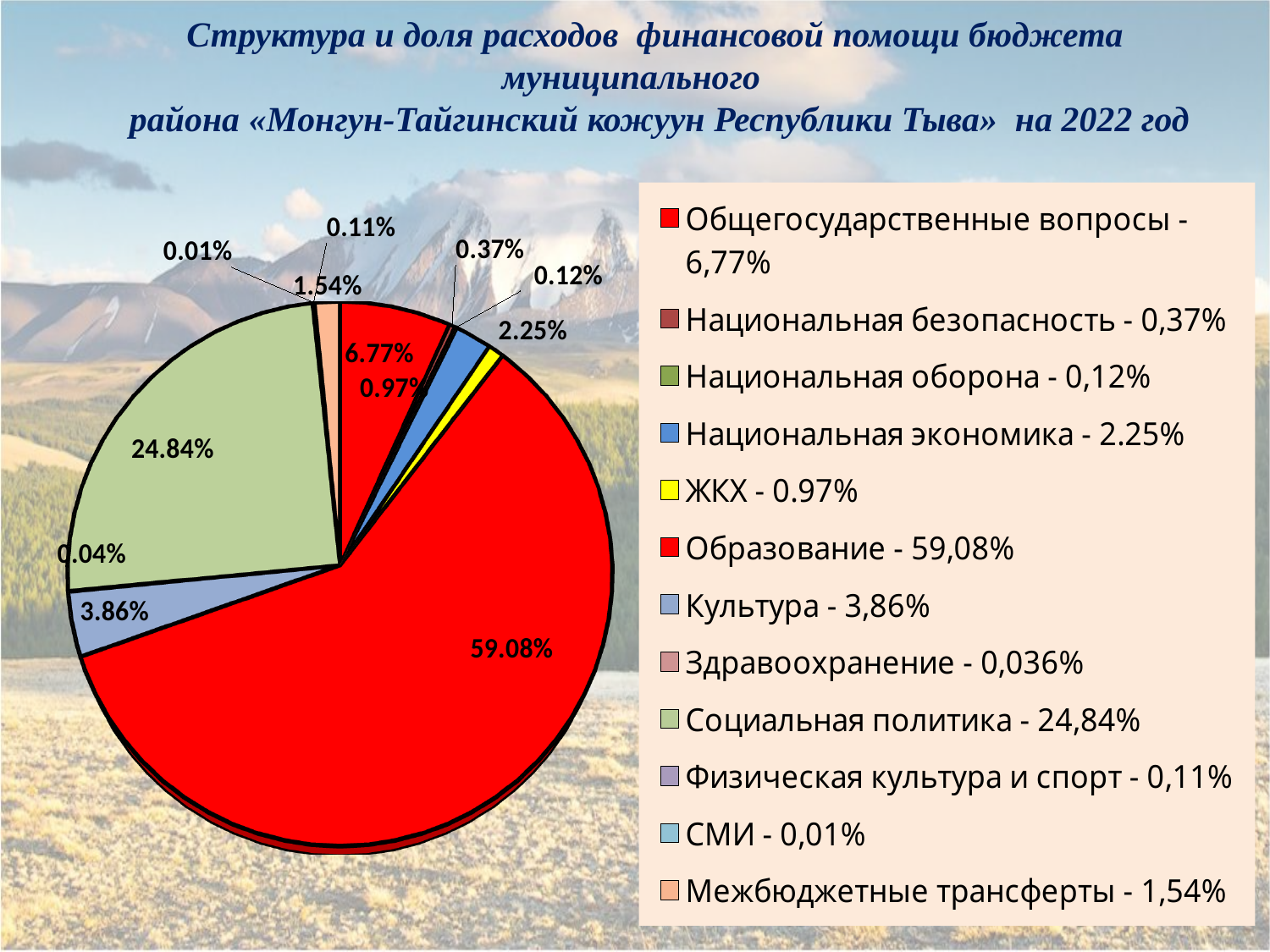
Which category has the smallest slice of the pie chart? СМИ What is the share of Социальная политика in the pie chart? 24.84% How many categories does the legend of the pie chart list? 12 What is the share of Образование in the pie chart? 59.08% What is the share of Межбюджетные трансферты in the pie chart? 1.54% What is the share of Общегосударственные вопросы in the pie chart? 6.77% What is the share of Национальная экономика in the pie chart? 2.25% Which category has the largest slice of the pie chart? Образование What is the share of Культура in the pie chart? 3.86% Which is larger in the pie chart: Социальная политика or Общегосударственные вопросы? Социальная политика What kind of chart is shown on the slide? pie chart What is the difference between the shares of Образование and Социальная политика in the pie chart? 34.24%